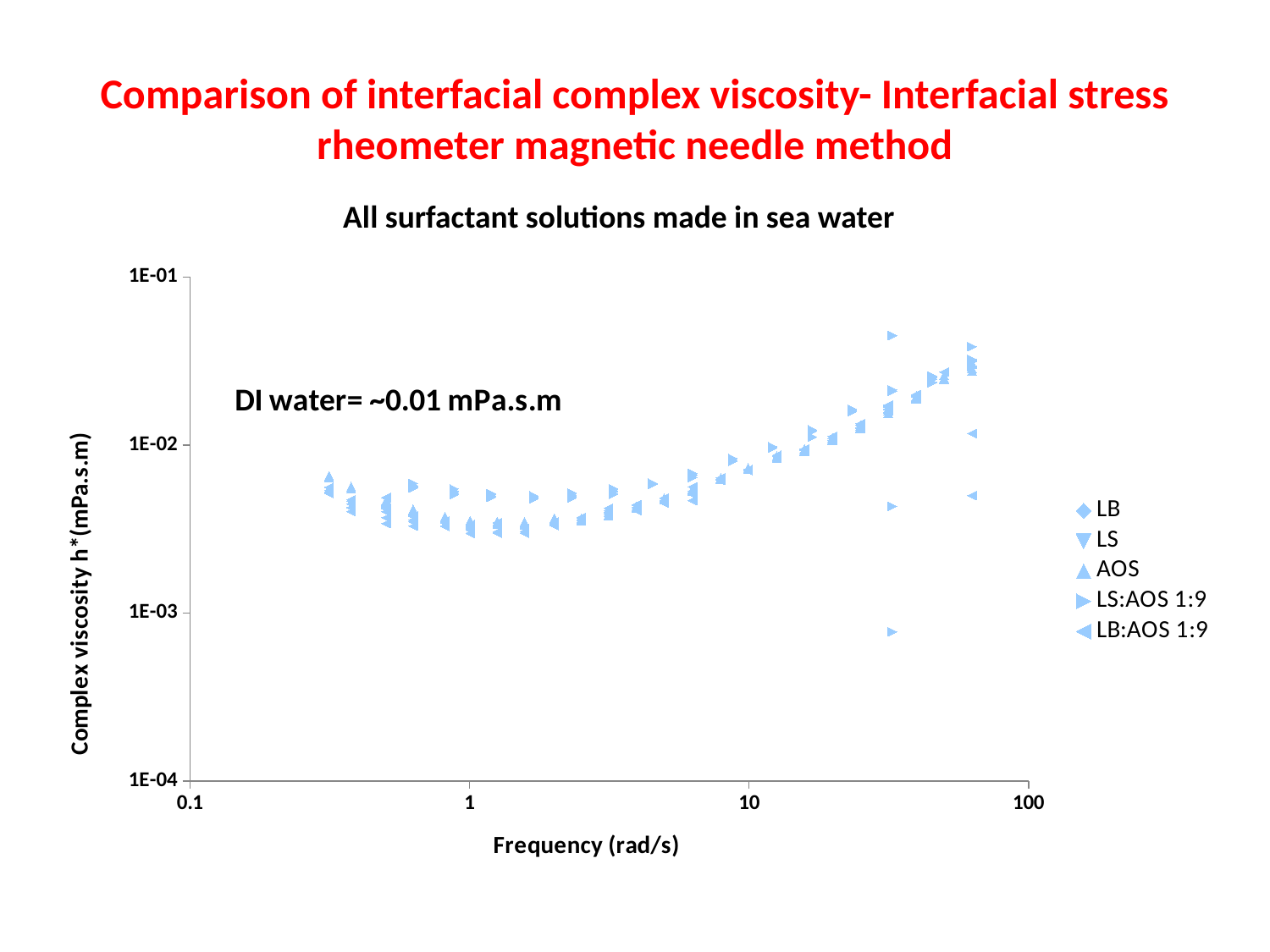
Are the plotted complex viscosity values at a frequency of 1 rad/s greater or less than 1E-02? less What is the highest value shown on the x axis? 100 Are the plotted values at a frequency of 1 rad/s greater or less than 1E-03? greater Which series is listed last in the legend? LB:AOS 1:9 What kind of chart is shown on the slide? Scatter chart What is the label of the x axis? Frequency (rad/s) Which series is listed first in the legend? LB What is the lowest value shown on the y axis? 1E-04 According to the annotation on the chart, what is the complex viscosity of DI water? ~0.01 mPa.s.m What is the title of the chart? All surfactant solutions made in sea water How many series does the legend list? 5 Do the complex viscosity values rise or fall as frequency increases from 10 rad/s toward 100 rad/s? rise